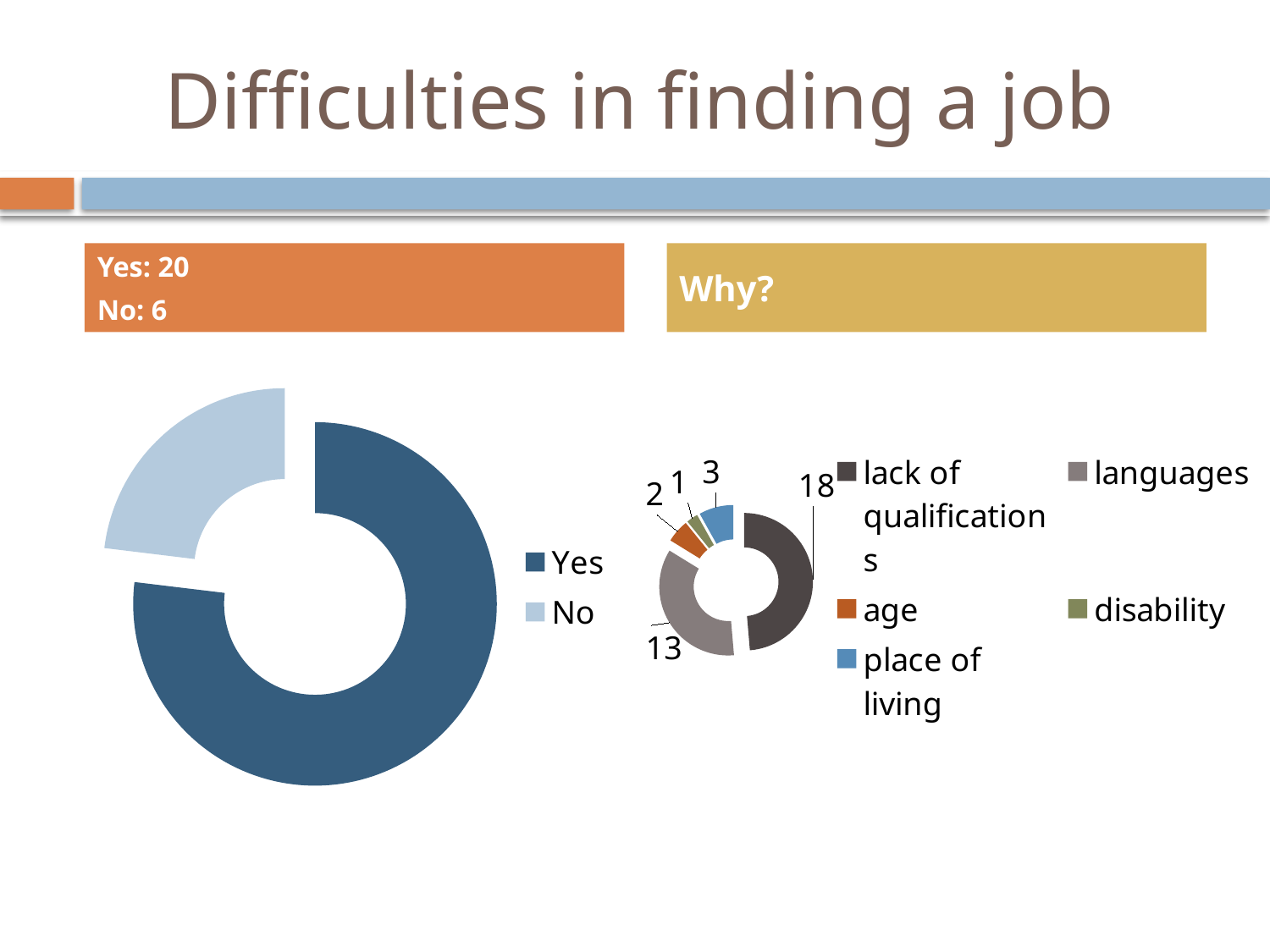
How many categories does the left chart (Yes/No) show? 2 In the right chart (reasons), what is the value for place of living? 3 In the left chart (Yes/No), which category has the larger share? Yes What kind of chart is the left chart showing Yes and No? Doughnut chart In the right chart (reasons), what is the value for lack of qualifications? 18 How many categories does the right chart (reasons) show? 5 In the right chart (reasons), what is the difference between lack of qualifications and languages? 5 In the right chart (reasons), what is the value for age? 2 In the right chart (reasons), which category has the smallest value? disability In the left chart, what is the value for Yes? 20 In the right chart (reasons), which category has the largest value? lack of qualifications In the right chart (reasons), what is the value for languages? 13